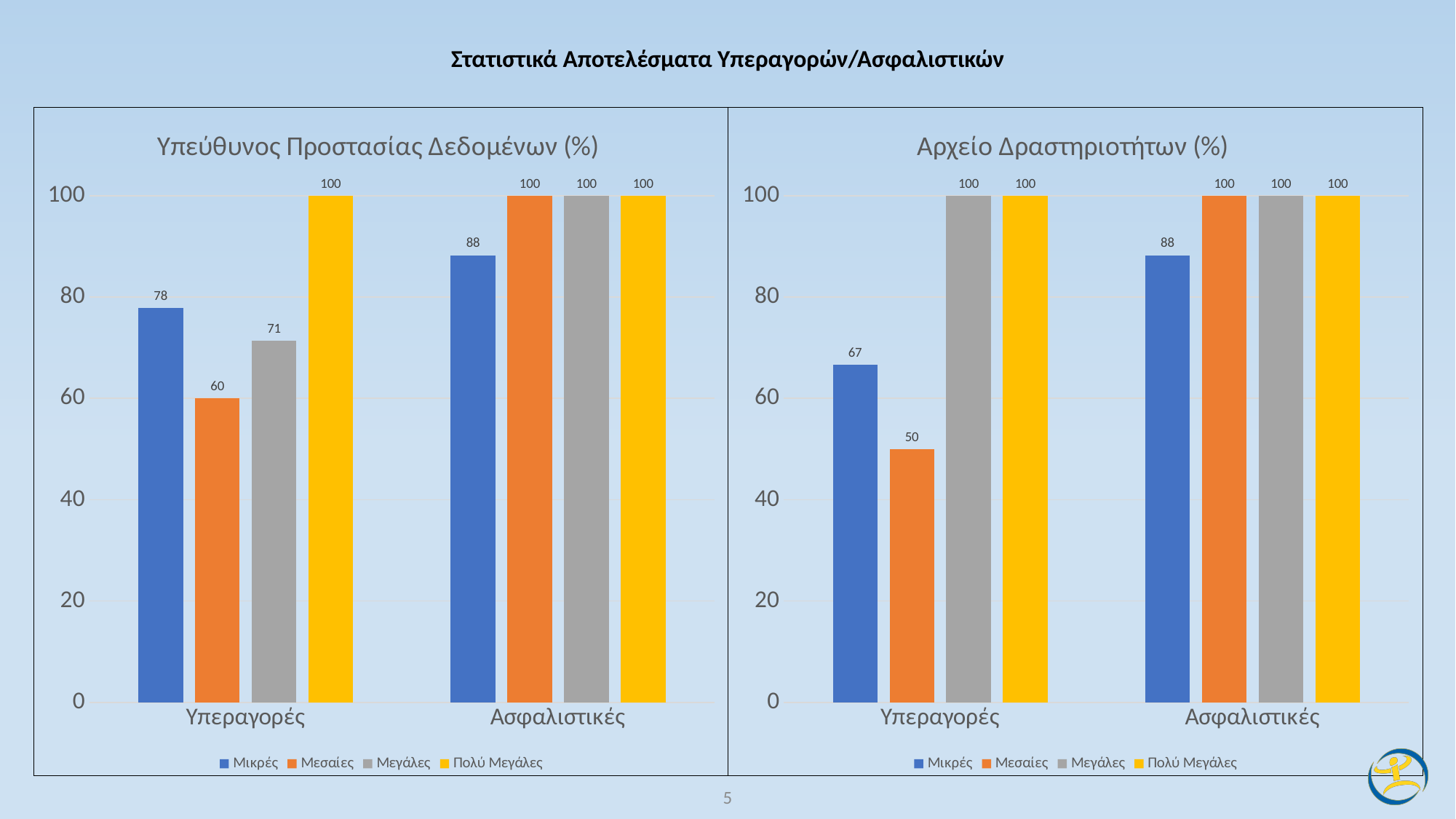
In the chart titled 'Αρχείο Δραστηριοτήτων (%)', what is the value for Μικρές in the Ασφαλιστικές category? 88 In the chart titled 'Υπεύθυνος Προστασίας Δεδομένων (%)', what is the difference between the Μικρές values for Ασφαλιστικές and Υπεραγορές? 10 In the chart titled 'Αρχείο Δραστηριοτήτων (%)', what is the difference between the Μικρές and Μεσαίες values in the Υπεραγορές category? 17 In the chart titled 'Υπεύθυνος Προστασίας Δεδομένων (%)', which series has the lowest value in the Υπεραγορές category? Μεσαίες In the chart titled 'Αρχείο Δραστηριοτήτων (%)', which series has the lowest value in the Ασφαλιστικές category? Μικρές In the chart titled 'Αρχείο Δραστηριοτήτων (%)', what is the value for Μεσαίες in the Υπεραγορές category? 50 In the chart titled 'Υπεύθυνος Προστασίας Δεδομένων (%)', what is the value for Μικρές in the Υπεραγορές category? 78 What kind of chart is the chart titled 'Υπεύθυνος Προστασίας Δεδομένων (%)'? Bar chart In the chart titled 'Υπεύθυνος Προστασίας Δεδομένων (%)', what is the value for Μεγάλες in the Υπεραγορές category? 71 How many series does the legend list in the chart titled 'Αρχείο Δραστηριοτήτων (%)'? 4 In the chart titled 'Υπεύθυνος Προστασίας Δεδομένων (%)', which is larger in the Υπεραγορές category: Μικρές or Μεγάλες? Μικρές How many categories are shown on the x axis of the chart titled 'Αρχείο Δραστηριοτήτων (%)'? 2